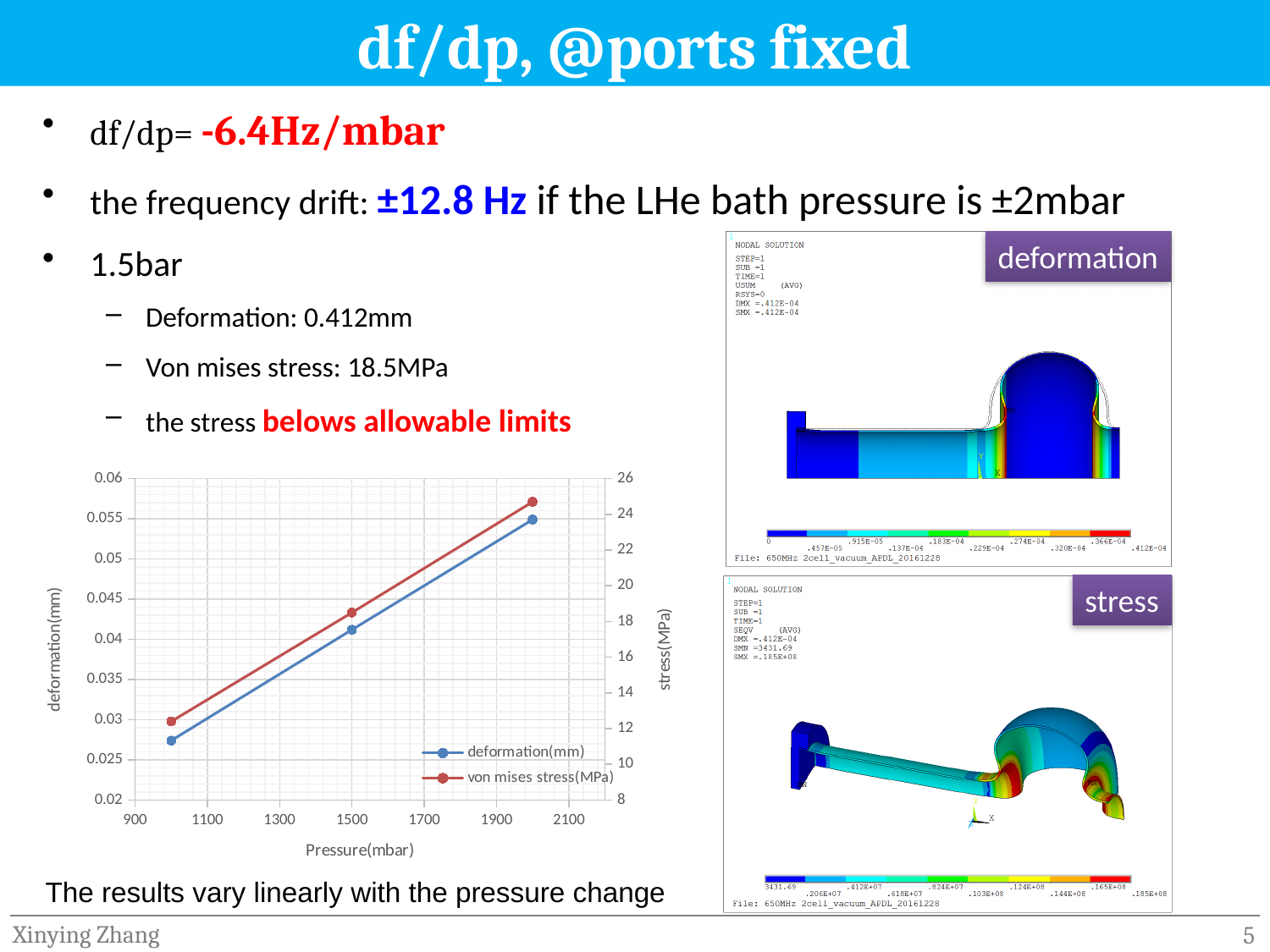
At which pressure is the deformation(mm) value highest? 2000 What kind of chart is shown on the slide? line chart Is the deformation(mm) value at 2000 mbar greater or less than 0.05? greater Do the von mises stress(MPa) values rise or fall as pressure increases? rise What is the title of the x axis of the chart? Pressure(mbar) Is the deformation(mm) value at 1000 mbar greater or less than 0.03? less How many data points are plotted for the deformation(mm) series? 3 Which is larger, the deformation(mm) value at 1000 mbar or at 2000 mbar? 2000 mbar Do the deformation(mm) values rise or fall as pressure increases along the x axis? rise At which pressure is the von mises stress(MPa) value lowest? 1000 Is the von mises stress(MPa) value at 2000 mbar greater or less than 22? greater How many series does the chart legend list? 2